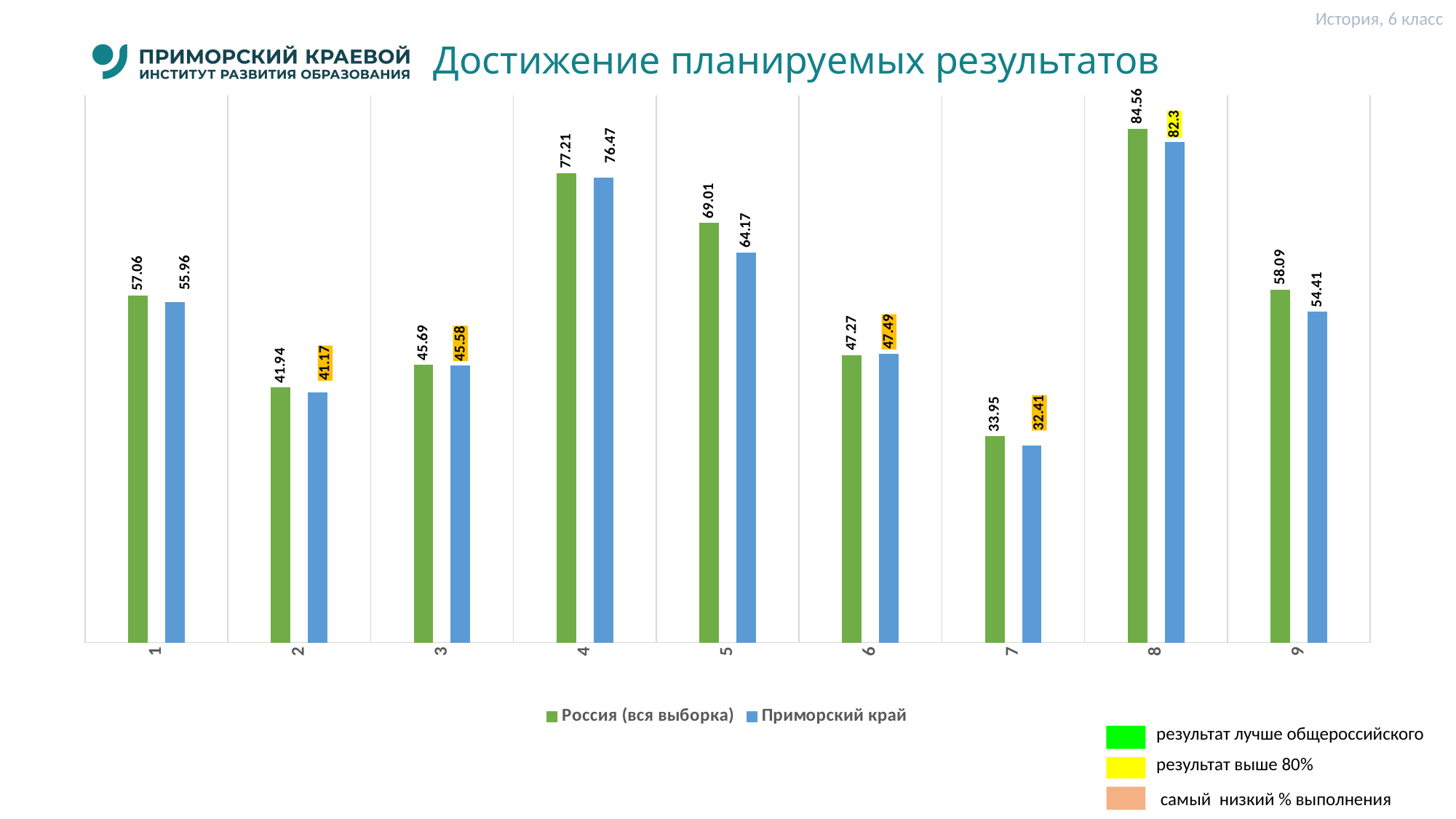
How many categories are shown on the x axis? 9 What is the difference between Россия (вся выборка) and Приморский край in category 8? 2.26 What is the value for Россия (вся выборка) in category 4? 77.21 How many series does the legend list? 2 In category 9, which is larger: Россия (вся выборка) or Приморский край? Россия (вся выборка) Which category has the lowest value for Приморский край? 7 What type of chart is shown on the slide? bar chart What is the difference between Россия (вся выборка) and Приморский край in category 5? 4.84 Which category has the highest value for Россия (вся выборка)? 8 What is the value for Приморский край in category 8? 82.3 What is the title of the chart? Достижение планируемых результатов What is the value for Приморский край in category 7? 32.41